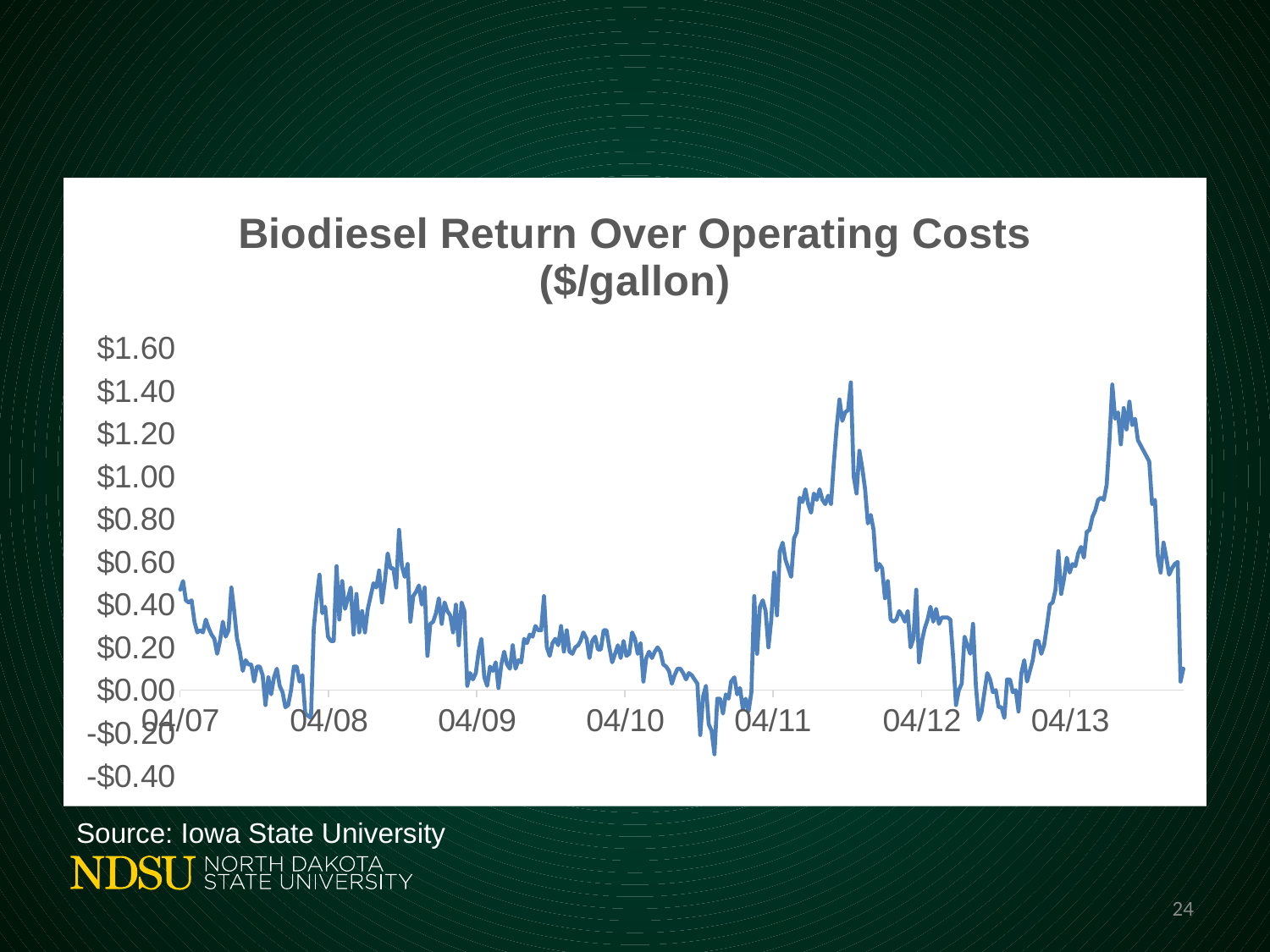
What is the title of the chart? Biodiesel Return Over Operating Costs ($/gallon) Is the value at 04/07 greater or less than $0.20? greater Is the value at 04/12 greater or less than $0.00? greater Does the line rise or fall from its peak after 04/13 to the end of the series? fall Is the value at 04/13 greater or less than $0.20? greater What type of chart is shown on the slide? line chart What source is cited for the chart? Iowa State University Does the line rise or fall between 04/11 and the peak that follows it? rise How many date labels are shown on the x axis? 7